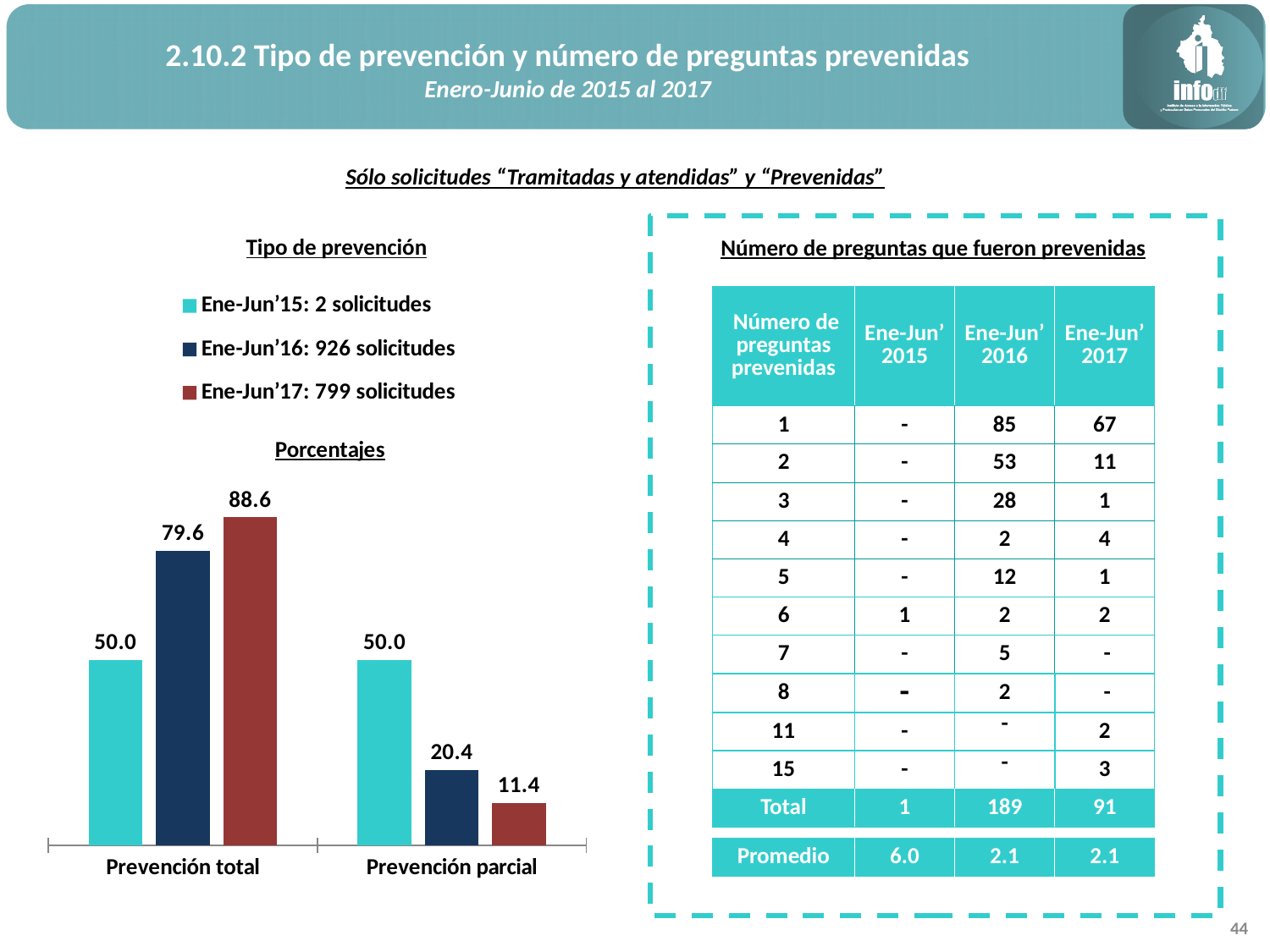
In the "Tipo de prevención" chart, what is the value for Ene-Jun'17 in Prevención total? 88.6 In the "Tipo de prevención" chart, what is the value for Ene-Jun'15 in Prevención total? 50.0 In the "Tipo de prevención" chart, which series has the highest value in Prevención total? Ene-Jun'17: 799 solicitudes In the "Tipo de prevención" chart, which is larger: the Ene-Jun'16 value in Prevención parcial or the Ene-Jun'17 value in Prevención parcial? Ene-Jun'16 (20.4) In the "Tipo de prevención" chart, how many solicitudes does the legend give for Ene-Jun'16? 926 solicitudes In the "Tipo de prevención" chart, what is the value for Ene-Jun'17 in Prevención parcial? 11.4 In the "Tipo de prevención" chart, which series has the lowest value in Prevención parcial? Ene-Jun'17: 799 solicitudes How many series does the legend of the "Tipo de prevención" chart list? 3 What type of chart is shown under "Tipo de prevención"? Bar chart How many categories are shown on the x axis of the "Tipo de prevención" chart? 2 In the "Tipo de prevención" chart, what is the difference between the Ene-Jun'17 and Ene-Jun'16 values in Prevención total? 9.0 In the "Tipo de prevención" chart, what is the value for Ene-Jun'16 in Prevención parcial? 20.4